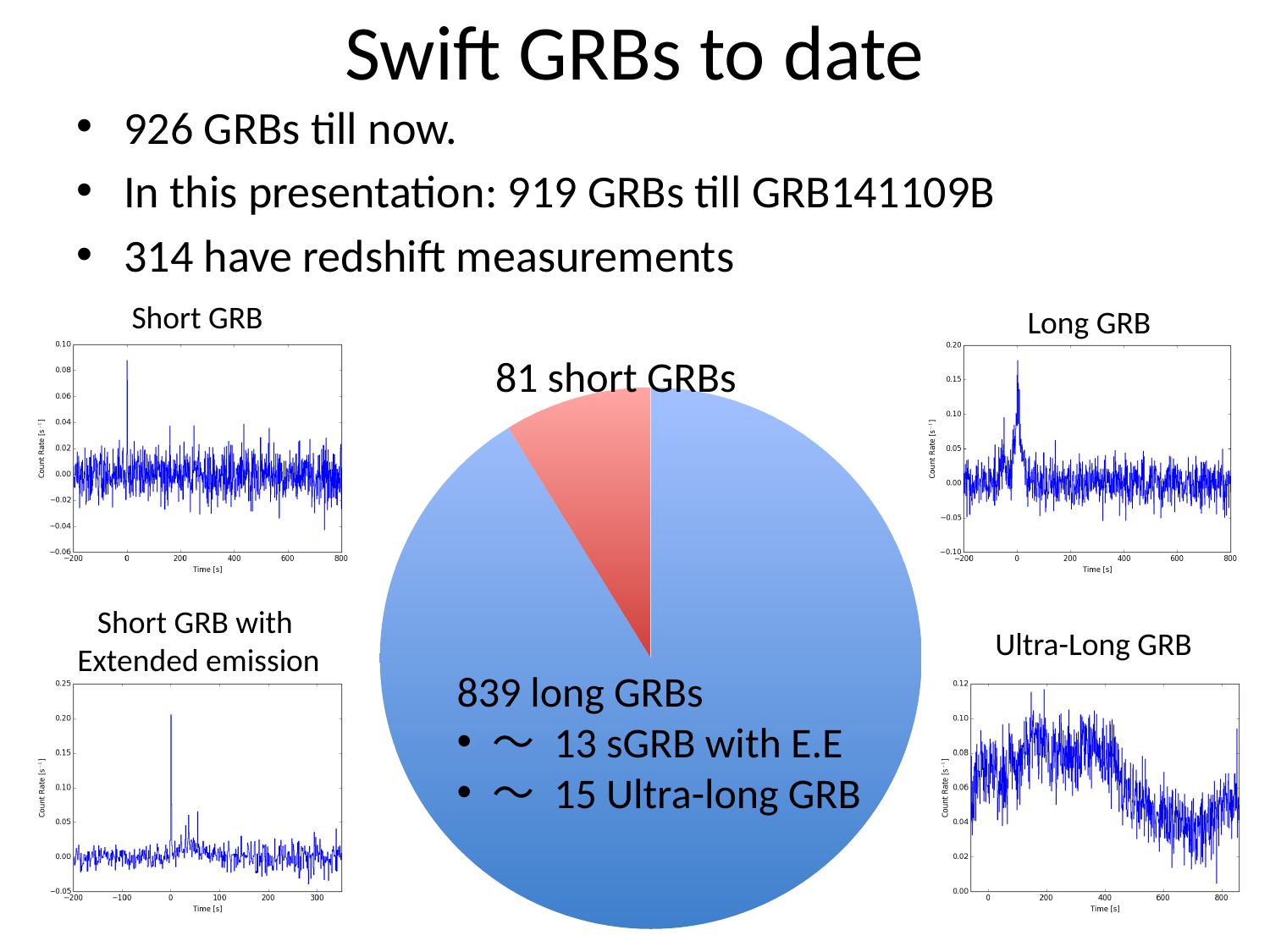
What kind of chart is the 'Long GRB' chart on the right of the slide? line chart How many line charts of GRB light curves are shown around the pie chart? 4 In the centre pie chart, how many GRBs are in the long GRB slice? 839 What is the x-axis label of the 'Ultra-Long GRB' chart? Time [s] In the centre pie chart, how many slices are there? 2 In the 'Long GRB' chart, is the peak count rate greater or less than 0.15? greater In the centre pie chart, what colour is the short GRB slice? red In the centre pie chart, what is the total number of GRBs across both slices? 920 In the centre pie chart, how many GRBs are in the short GRB slice? 81 What kind of chart is the chart in the centre of the slide? pie chart In the centre pie chart, how many more long GRBs are there than short GRBs? 758 In the centre pie chart, which slice is larger, short GRBs or long GRBs? long GRBs